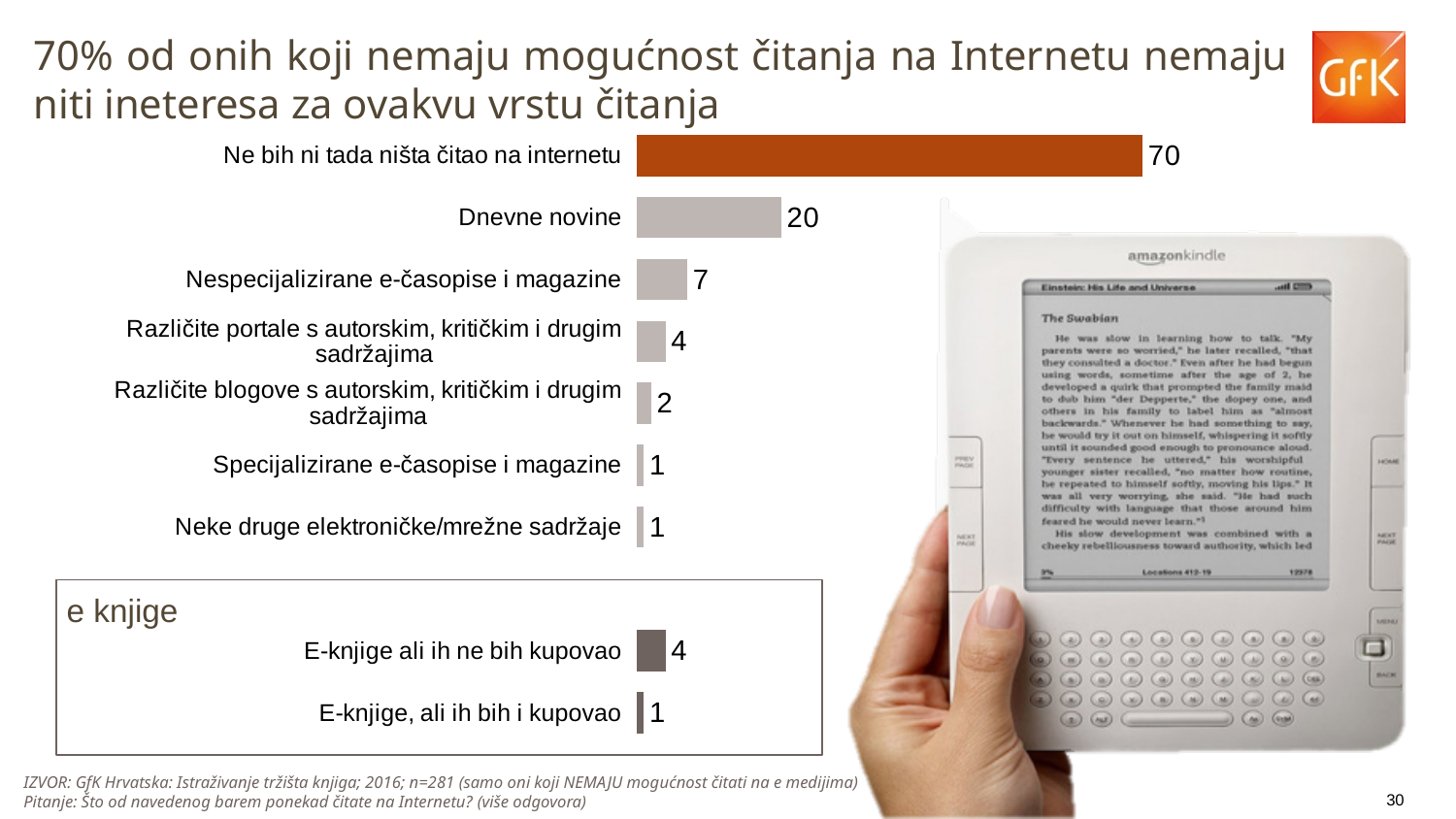
What is the value for "Ne bih ni tada ništa čitao na internetu"? 70 What is the value for "Nespecijalizirane e-časopise i magazine"? 7 What is the value for "Različite blogove s autorskim, kritičkim i drugim sadržajima"? 2 What kind of chart is shown on the slide? Bar chart What is the label of the boxed section at the bottom of the chart? e knjige What is the value for "Dnevne novine"? 20 How many categories are shown in the chart? 9 What is the value for "E-knjige ali ih ne bih kupovao"? 4 What is the difference between the values for "Ne bih ni tada ništa čitao na internetu" and "Dnevne novine"? 50 Which is larger, the value for "E-knjige ali ih ne bih kupovao" or the value for "E-knjige, ali ih bih i kupovao"? E-knjige ali ih ne bih kupovao What is the difference between the values for "Dnevne novine" and "Nespecijalizirane e-časopise i magazine"? 13 Which category has the highest value? Ne bih ni tada ništa čitao na internetu